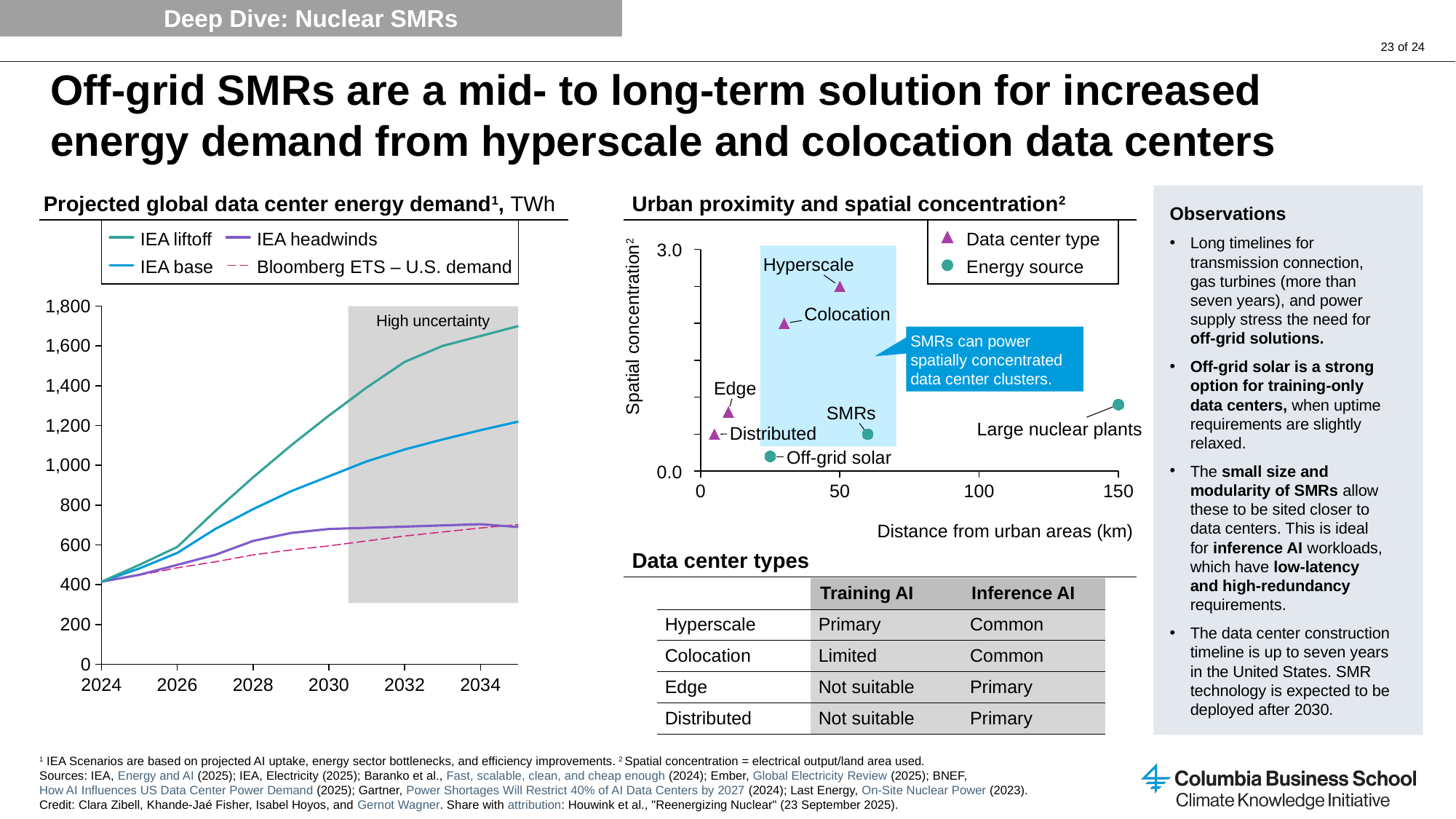
In the 'Urban proximity and spatial concentration' chart, is the distance from urban areas for Large nuclear plants greater or less than 100 km? greater In the 'Projected global data center energy demand' chart, what label is shown on the shaded region covering the later years? High uncertainty In the 'Urban proximity and spatial concentration' chart, which point has the highest spatial concentration? Hyperscale In the 'Projected global data center energy demand' chart, is the IEA headwinds value in 2034 greater or less than 800? less In the 'Projected global data center energy demand' chart, which series has the highest value in 2034? IEA liftoff In the 'Projected global data center energy demand' chart, does the IEA liftoff series rise or fall from 2024 to 2034? Rises How many series does the legend of the 'Projected global data center energy demand' chart list? 4 What kind of chart is the 'Projected global data center energy demand' chart? Line chart How many series does the legend of the 'Urban proximity and spatial concentration' chart list? 2 In the 'Projected global data center energy demand' chart, is the IEA liftoff value in 2034 greater or less than 1,600? greater In the 'Urban proximity and spatial concentration' chart, how many data center type points are plotted? 4 In the 'Projected global data center energy demand' chart, which is larger in 2032: IEA liftoff or IEA base? IEA liftoff